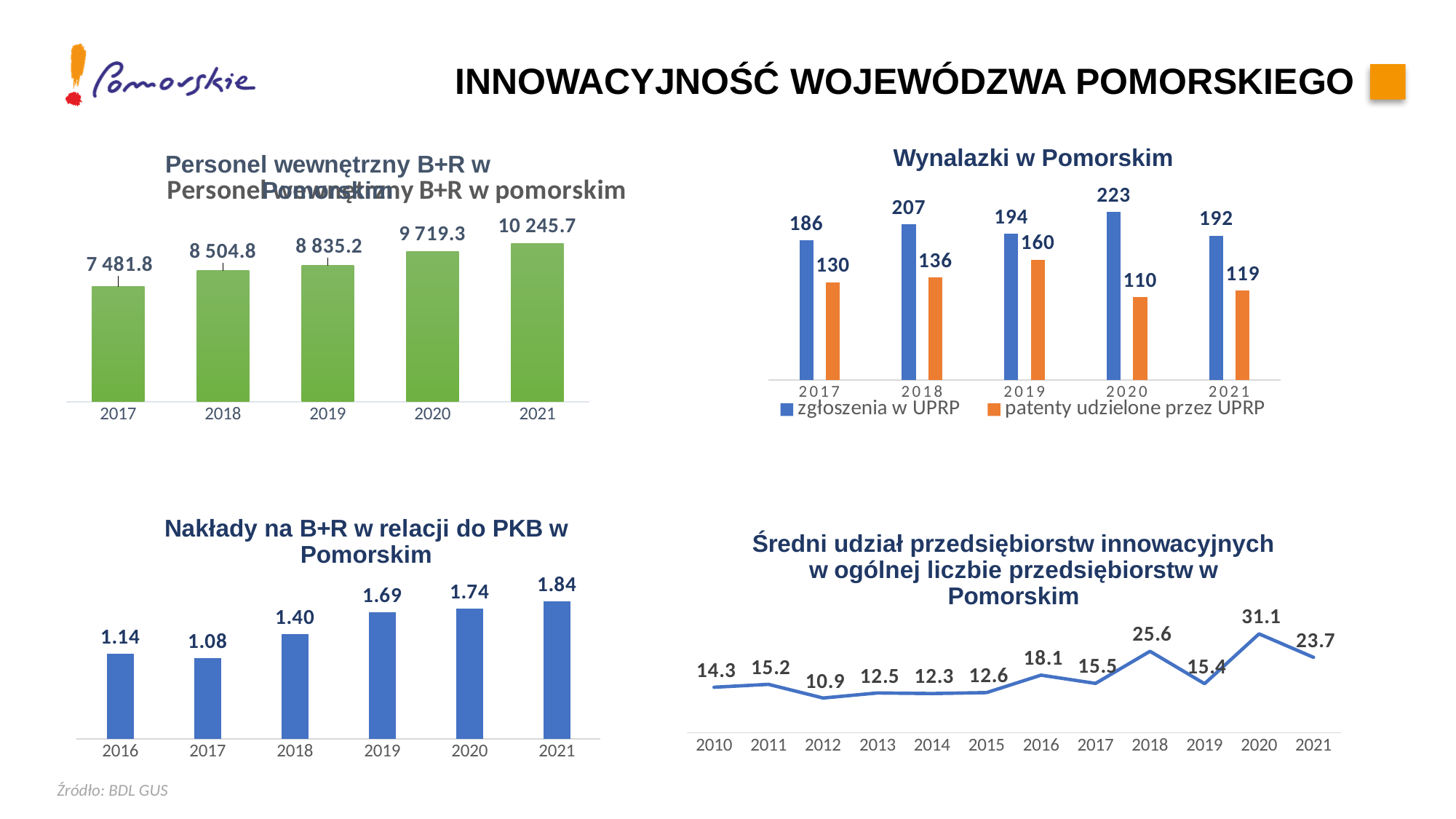
In the 'Wynalazki w Pomorskim' chart, which year has the highest value for 'patenty udzielone przez UPRP'? 2019 How many years are shown in the 'Nakłady na B+R w relacji do PKB w Pomorskim' chart? 6 In the top-left chart (Personel wewnętrzny B+R w Pomorskim), which year has the lowest value? 2017 In the top-left chart (Personel wewnętrzny B+R w Pomorskim), do the values rise or fall from 2017 to 2021? rise In the 'Nakłady na B+R w relacji do PKB w Pomorskim' chart, which year has the lowest value? 2017 In the 'Wynalazki w Pomorskim' chart, what is the difference between 'zgłoszenia w UPRP' and 'patenty udzielone przez UPRP' in 2021? 73 In the 'Średni udział przedsiębiorstw innowacyjnych' chart, which year has the highest value? 2020 How many series does the legend of the 'Wynalazki w Pomorskim' chart list? 2 What kind of chart is 'Średni udział przedsiębiorstw innowacyjnych w ogólnej liczbie przedsiębiorstw w Pomorskim'? line chart In the top-left chart (Personel wewnętrzny B+R w Pomorskim), what is the value for 2019? 8 835.2 In the 'Nakłady na B+R w relacji do PKB w Pomorskim' chart, what is the value for 2018? 1.40 In the 'Wynalazki w Pomorskim' chart, what is the value of 'zgłoszenia w UPRP' for 2020? 223